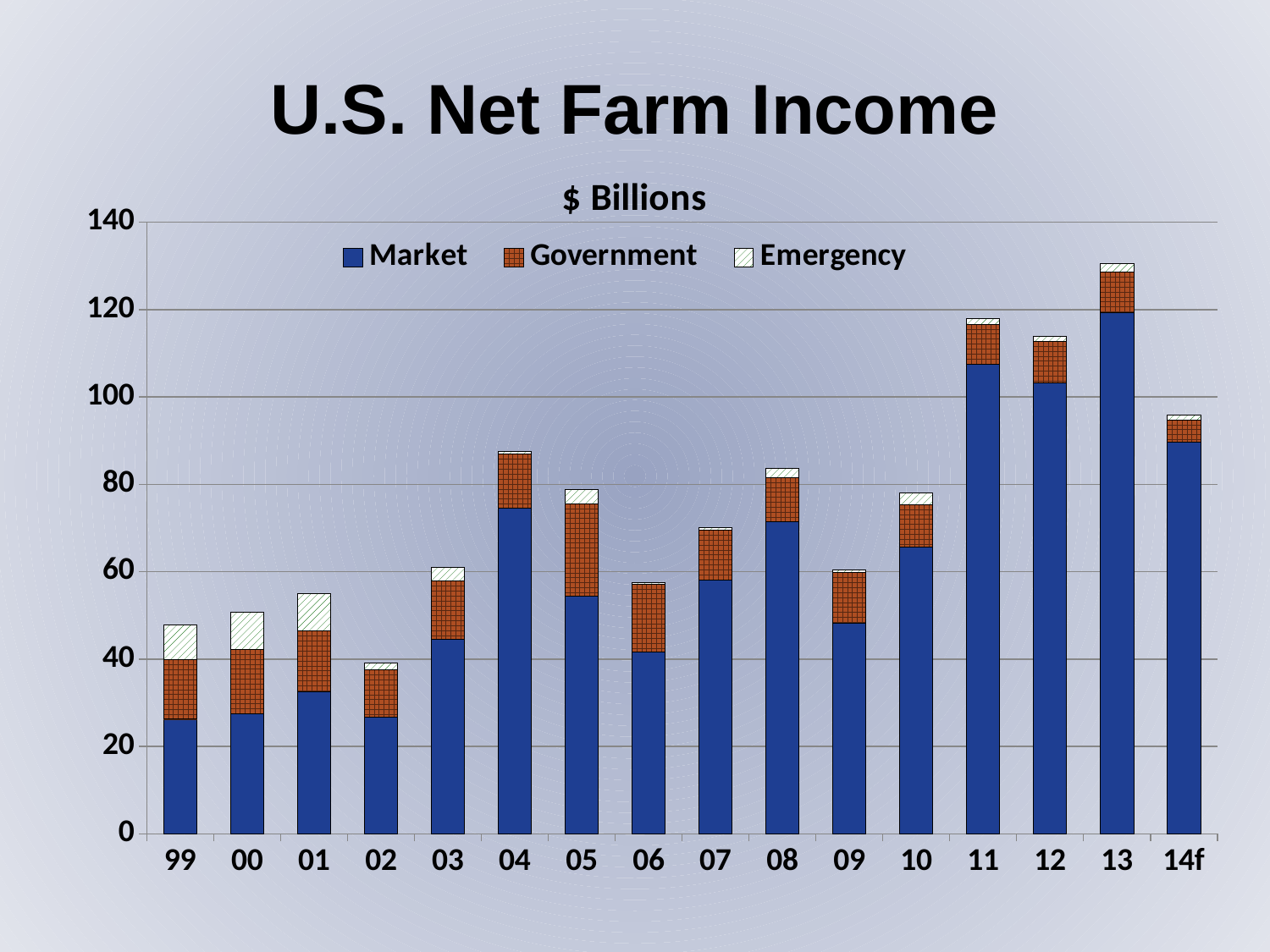
What unit is given in the chart's subtitle? $ Billions Which year has the larger total bar, 08 or 09? 08 Which year has the lowest total net farm income bar? 02 How many series does the legend list? 3 Is the Market segment for 11 greater or less than 100? greater Is the total bar for 99 greater or less than 60? less What kind of chart is shown on the slide? Stacked bar chart Which year has the larger Market segment, 05 or 06? 05 Is the total bar for 13 greater or less than 120? greater Do the total bars rise or fall from 10 to 13? rise Which year has the highest total net farm income bar? 13 How many years (categories) are shown on the x axis? 16